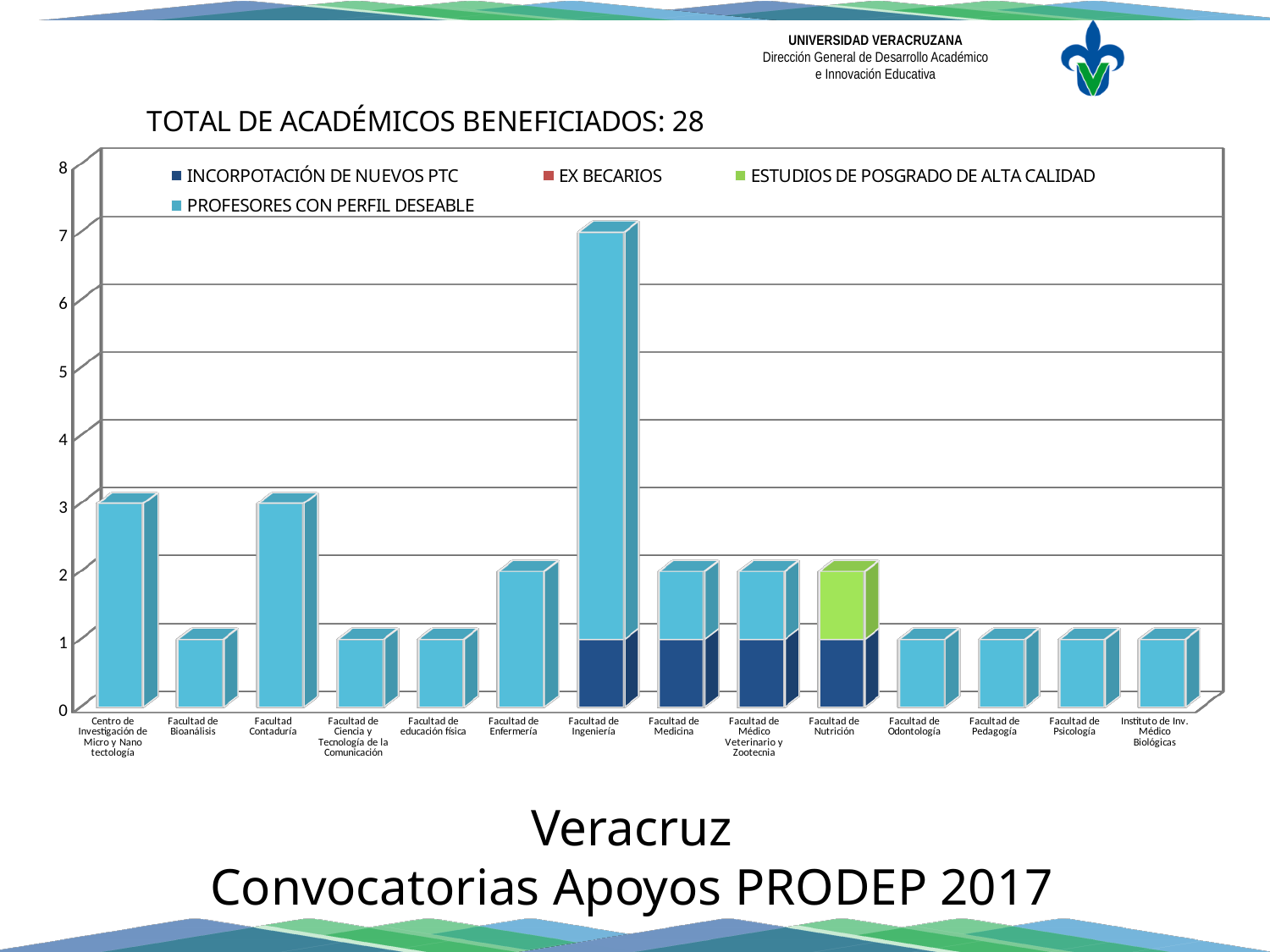
How many series does the chart legend list? 4 What is the ESTUDIOS DE POSGRADO DE ALTA CALIDAD value for Facultad de Nutrición? 1 What is the total height of the stacked bar for Facultad de Ingeniería? 7 What type of chart is shown on the slide? bar chart How many categories (faculties/institutes) are shown on the x axis? 14 What is the difference between the total for Facultad de Ingeniería and the total for Facultad Contaduría? 4 What is the value for Facultad Contaduría? 3 What is the value for Facultad de Enfermería? 2 Which category has the tallest bar? Facultad de Ingeniería What total number of beneficiaries is stated in the chart title? 28 What is the INCORPOTACIÓN DE NUEVOS PTC value for Facultad de Medicina? 1 Which is larger, the value for Centro de Investigación de Micro y Nano tectología or the value for Facultad de Bioanálisis? Centro de Investigación de Micro y Nano tectología